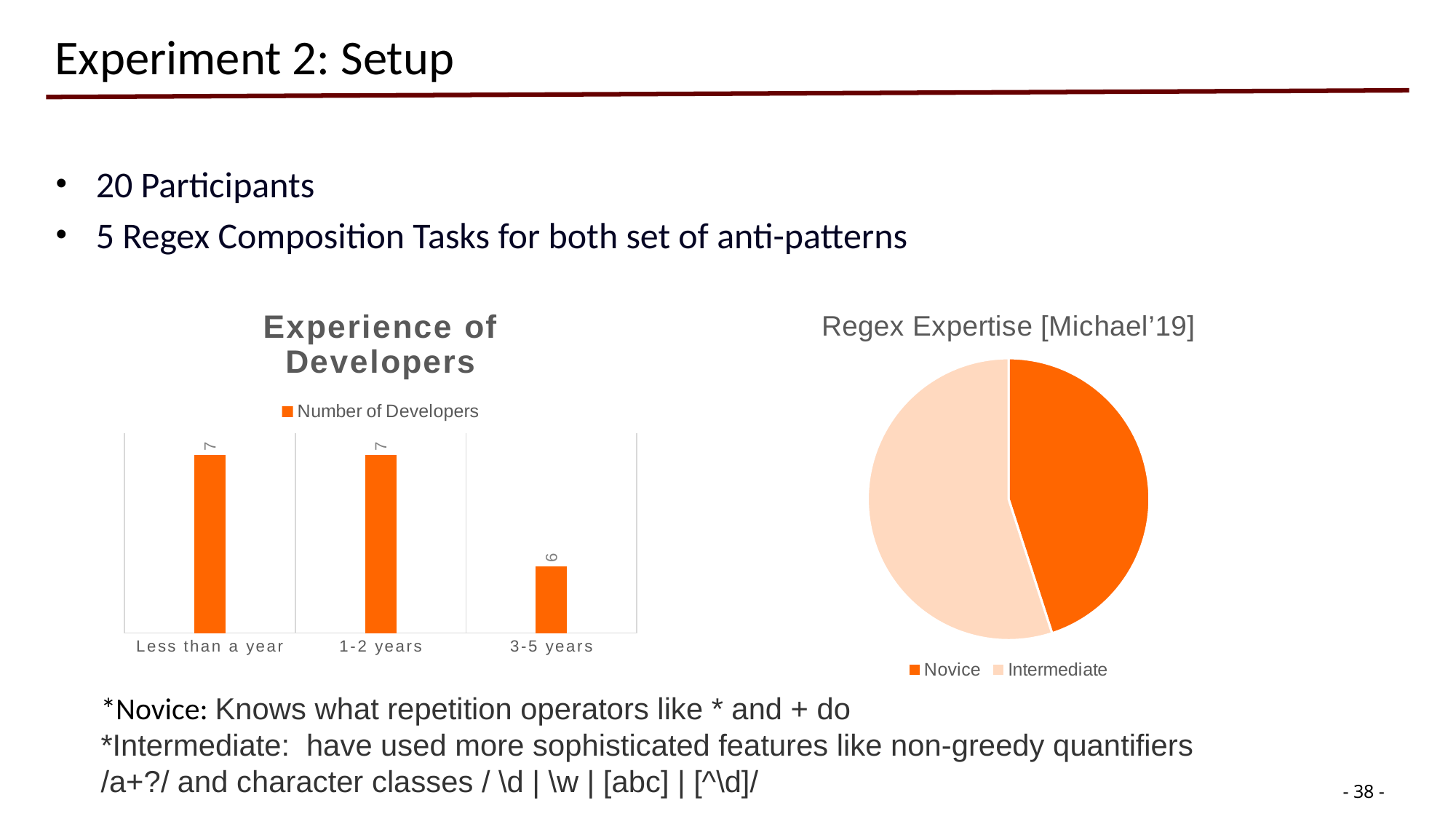
In the Experience of Developers chart, which experience category has the lowest number of developers? 3-5 years In the Regex Expertise [Michael'19] chart, which slice is larger, Novice or Intermediate? Intermediate In the Experience of Developers chart, what is the number of developers with 1-2 years of experience? 7 In the Experience of Developers chart, what is the number of developers with 3-5 years of experience? 6 In the Experience of Developers chart, what is the number of developers with less than a year of experience? 7 What kind of chart is the Regex Expertise [Michael'19] chart? Pie chart How many experience categories are shown in the Experience of Developers chart? 3 How many series does the legend of the Experience of Developers chart list? 1 How many categories does the legend of the Regex Expertise [Michael'19] chart list? 2 What kind of chart is the Experience of Developers chart? Bar chart In the Experience of Developers chart, what is the difference between the number of developers with 1-2 years and with 3-5 years of experience? 1 In the Experience of Developers chart, is the number of developers with less than a year of experience larger than the number with 3-5 years? Yes